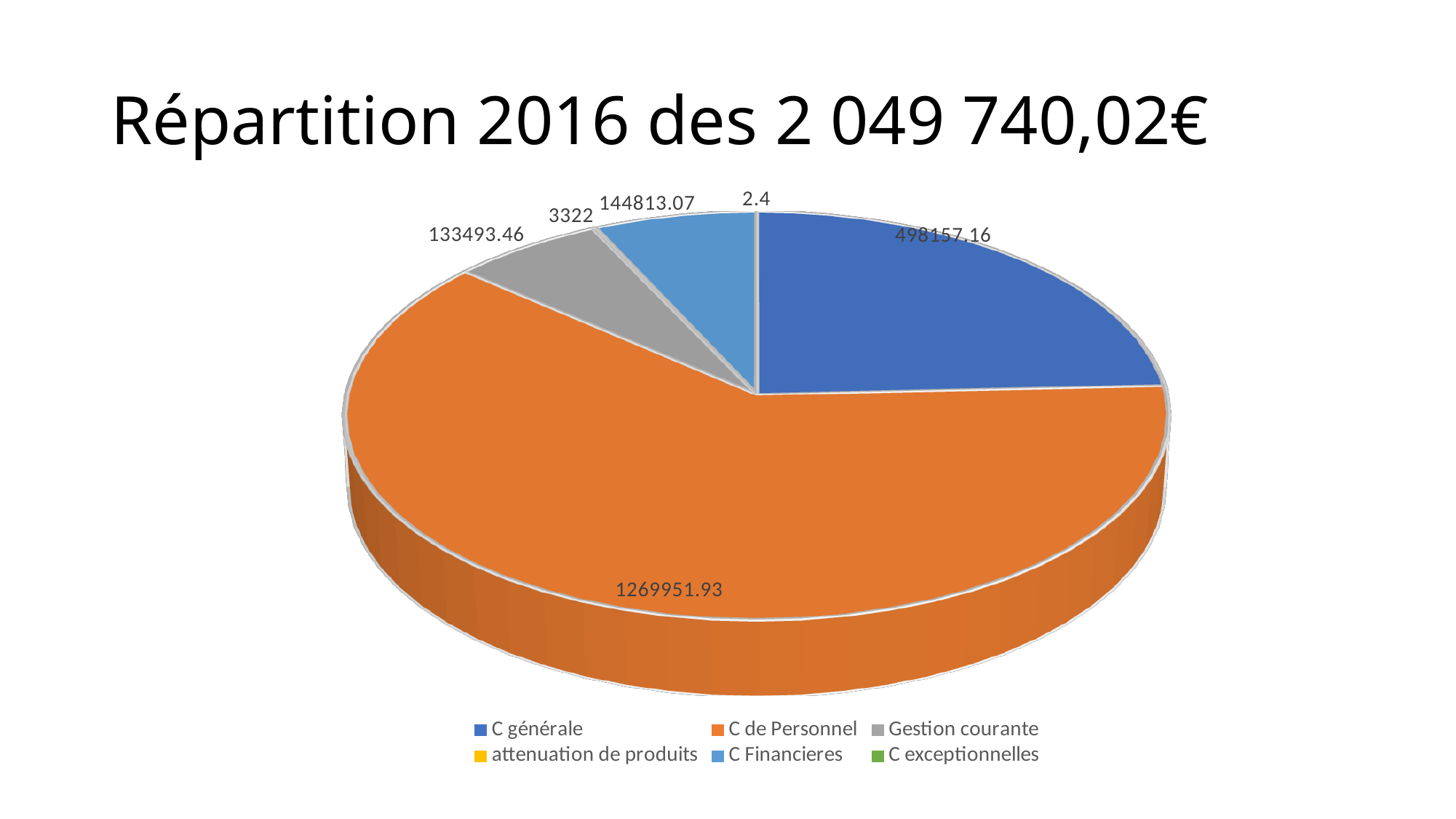
What is the value for C de Personnel? 1269951.93 What is the value for Gestion courante? 133493.46 Which category has the largest slice of the pie? C de Personnel What type of chart is shown on the slide? Pie chart What is the value for C exceptionnelles? 2.4 Which category has the smallest value? C exceptionnelles What is the value for C générale? 498157.16 Which is larger, the value for C Financieres or the value for Gestion courante? C Financieres What is the value for C Financieres? 144813.07 What is the difference between the values for C de Personnel and C générale? 771794.77 How many categories does the legend list? 6 What is the value for attenuation de produits? 3322